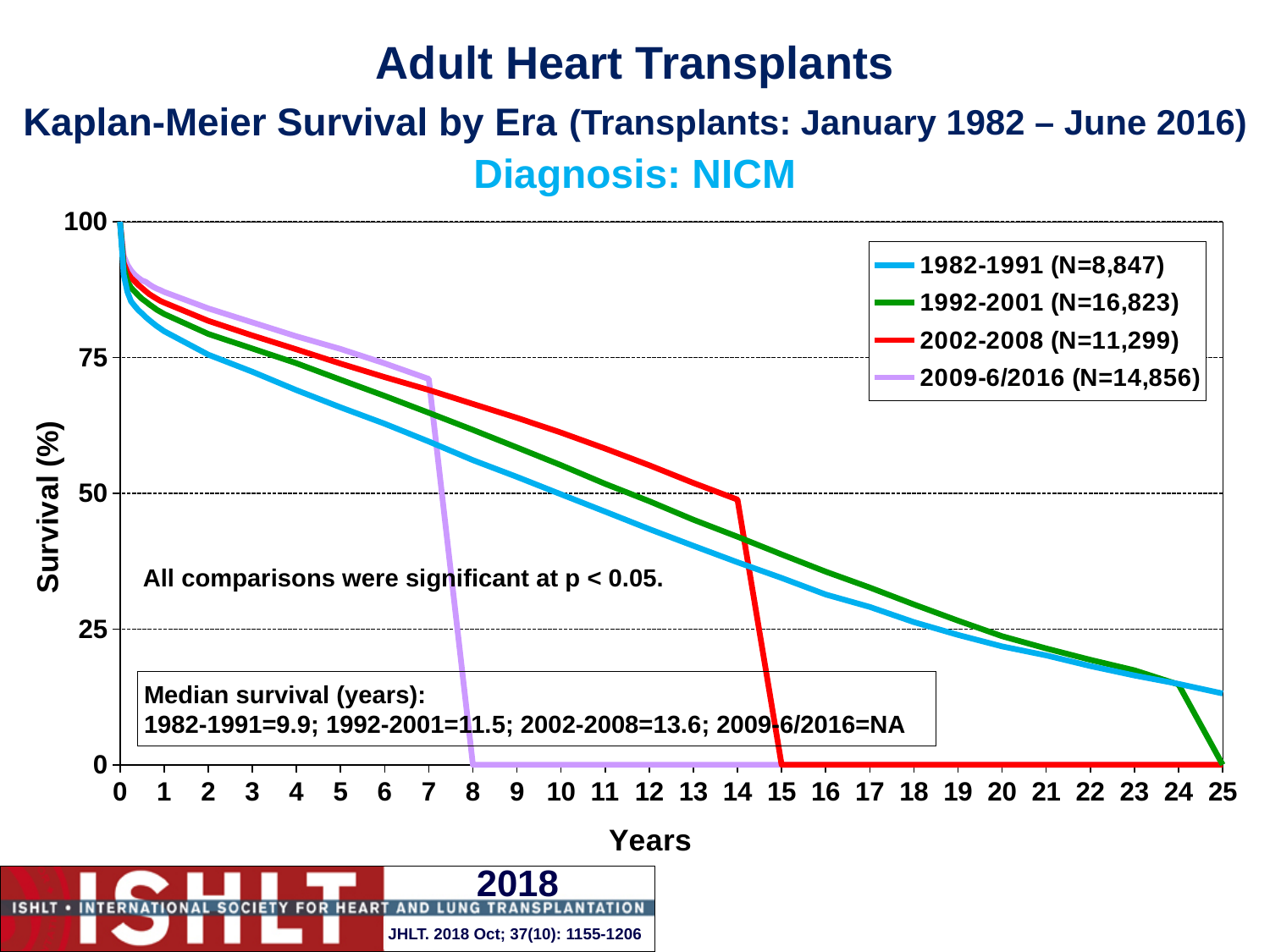
What is the median survival in years for the 2002-2008 era? 13.6 Is the survival for the 2002-2008 era at 10 years greater or less than 50? greater What kind of chart is shown on the slide? Line chart What is the median survival in years for the 1992-2001 era? 11.5 What is the N for the 1982-1991 era shown in the legend? 8,847 What is the difference in median survival (years) between the 2002-2008 era and the 1982-1991 era? 3.7 At 5 years, which era has higher survival: 1982-1991 or 2009-6/2016? 2009-6/2016 Do the survival curves rise or fall as years increase? Fall Is the survival for the 1982-1991 era at 15 years greater or less than 25? greater How many eras (series) does the legend list? 4 What is the median survival listed for the 2009-6/2016 era? NA Which era has the largest number of transplants (N) in the legend? 1992-2001